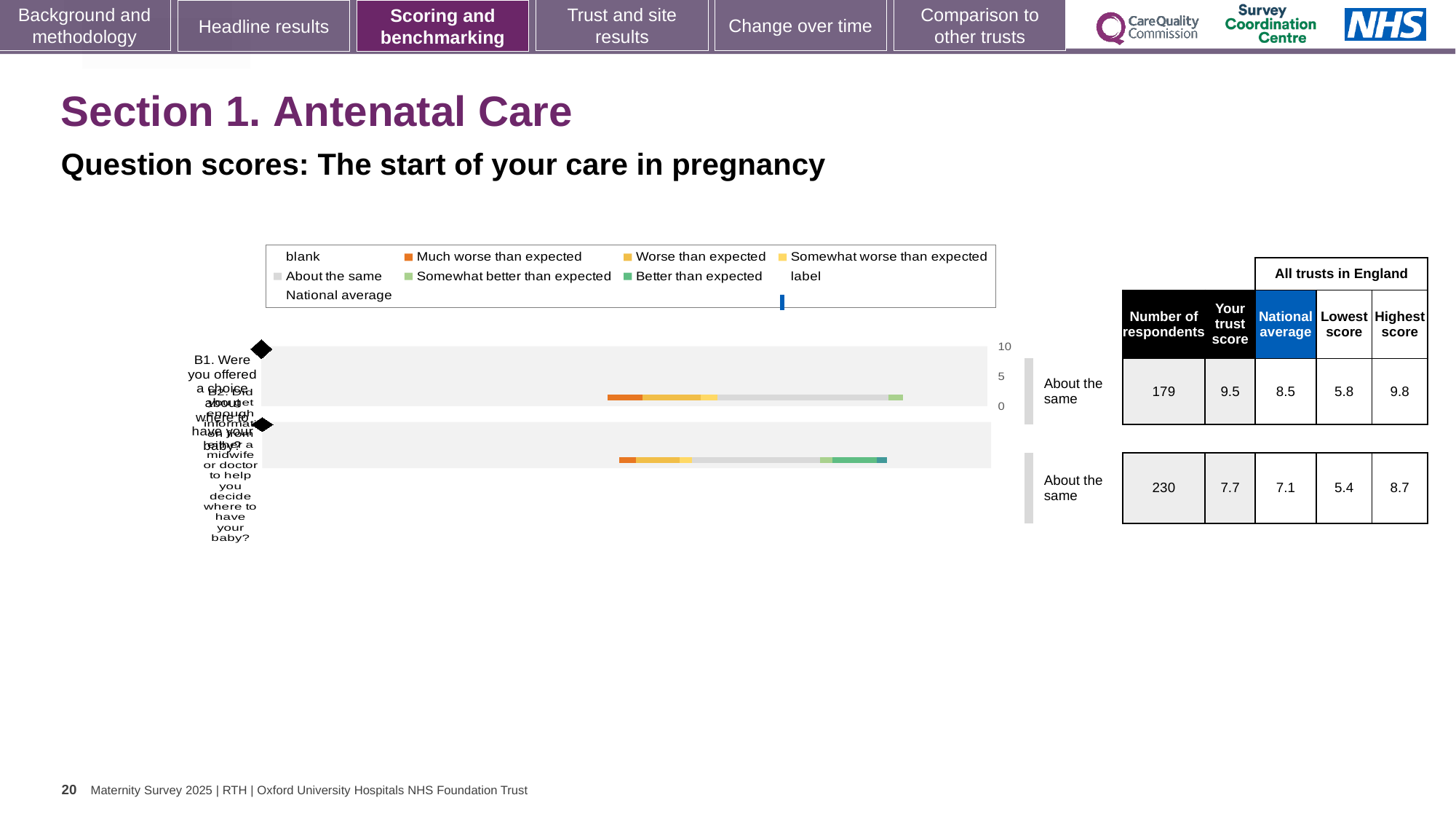
What kind of chart is shown on the slide? bar chart In the table beside the chart, what is the highest score for the second question (B2)? 8.7 In the table beside the chart, what is the number of respondents for the first question (B1)? 179 What is the highest value shown on the chart's axis? 10 For the first question (B1), which is larger: the trust score or the national average? trust score How many question bars are plotted in the chart? 2 How many entries does the chart legend list? 9 In the table beside the chart, what is the national average for the second question (B2)? 7.1 Which legend entry is shown in orange? Much worse than expected What is the difference between the trust score and the national average for the first question (B1)? 1.0 Which question has the larger number of respondents, B1 or B2? B2 In the table beside the chart, what is the trust score for the first question (B1)? 9.5